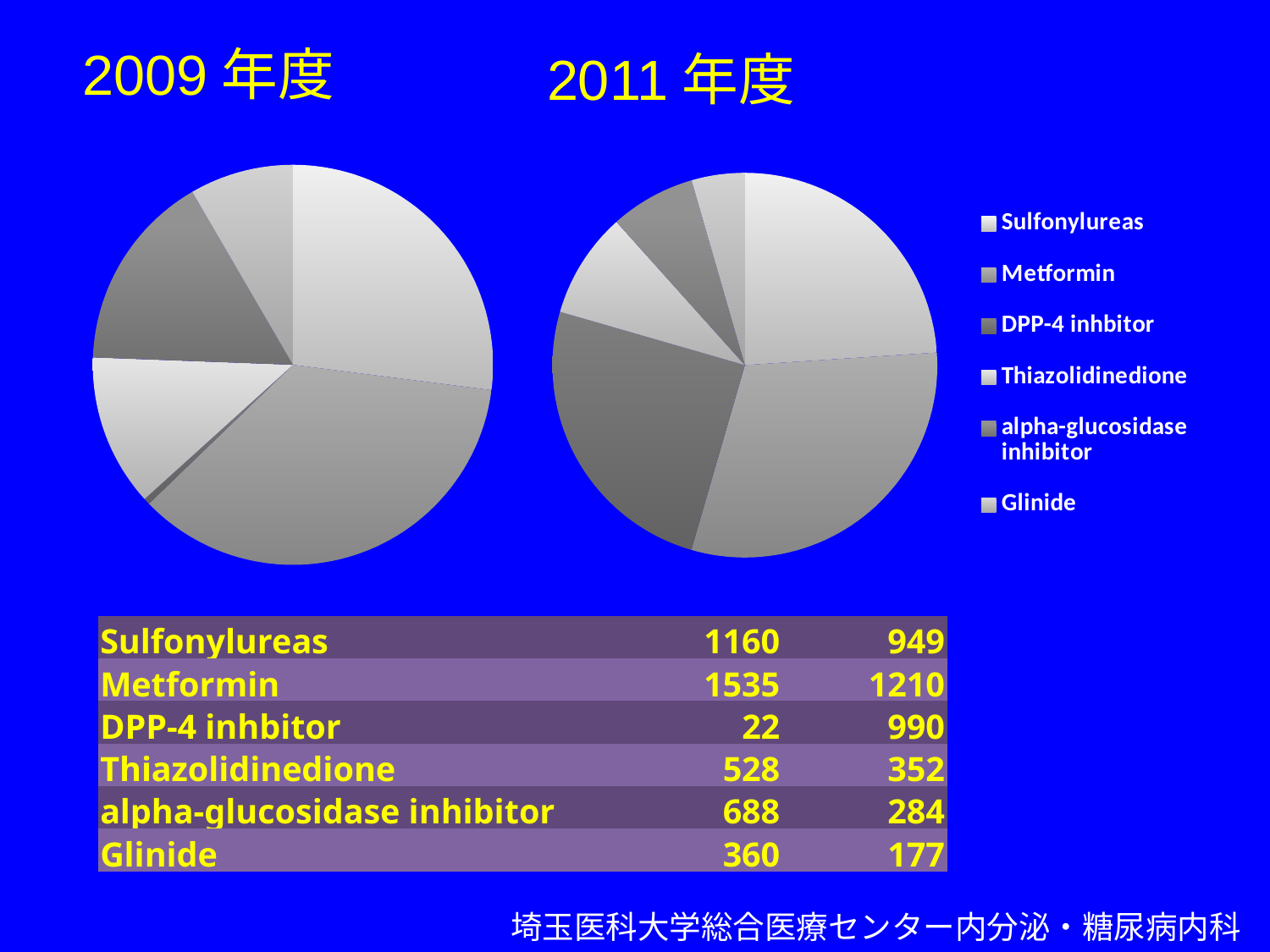
In the 2009 年度 chart, which category has the largest value? Metformin In the 2011 年度 chart, which category has the smallest value? Glinide How many categories does the legend list for the pie charts? 6 In the 2011 年度 chart, which is larger, Sulfonylureas or DPP-4 inhbitor? DPP-4 inhbitor In the 2011 年度 chart, what is the value for DPP-4 inhbitor? 990 In the 2009 年度 chart, what is the value for Metformin? 1535 What is the difference between the Sulfonylureas value in the 2009 年度 chart and in the 2011 年度 chart? 211 In the 2009 年度 chart, which category has the smallest value? DPP-4 inhbitor What kind of chart is used for the 2009 年度 and 2011 年度 data? pie chart In the 2009 年度 chart, what is the value for Glinide? 360 In the 2011 年度 chart, which category has the largest value? Metformin By how much did the DPP-4 inhbitor value increase from the 2009 年度 chart to the 2011 年度 chart? 968